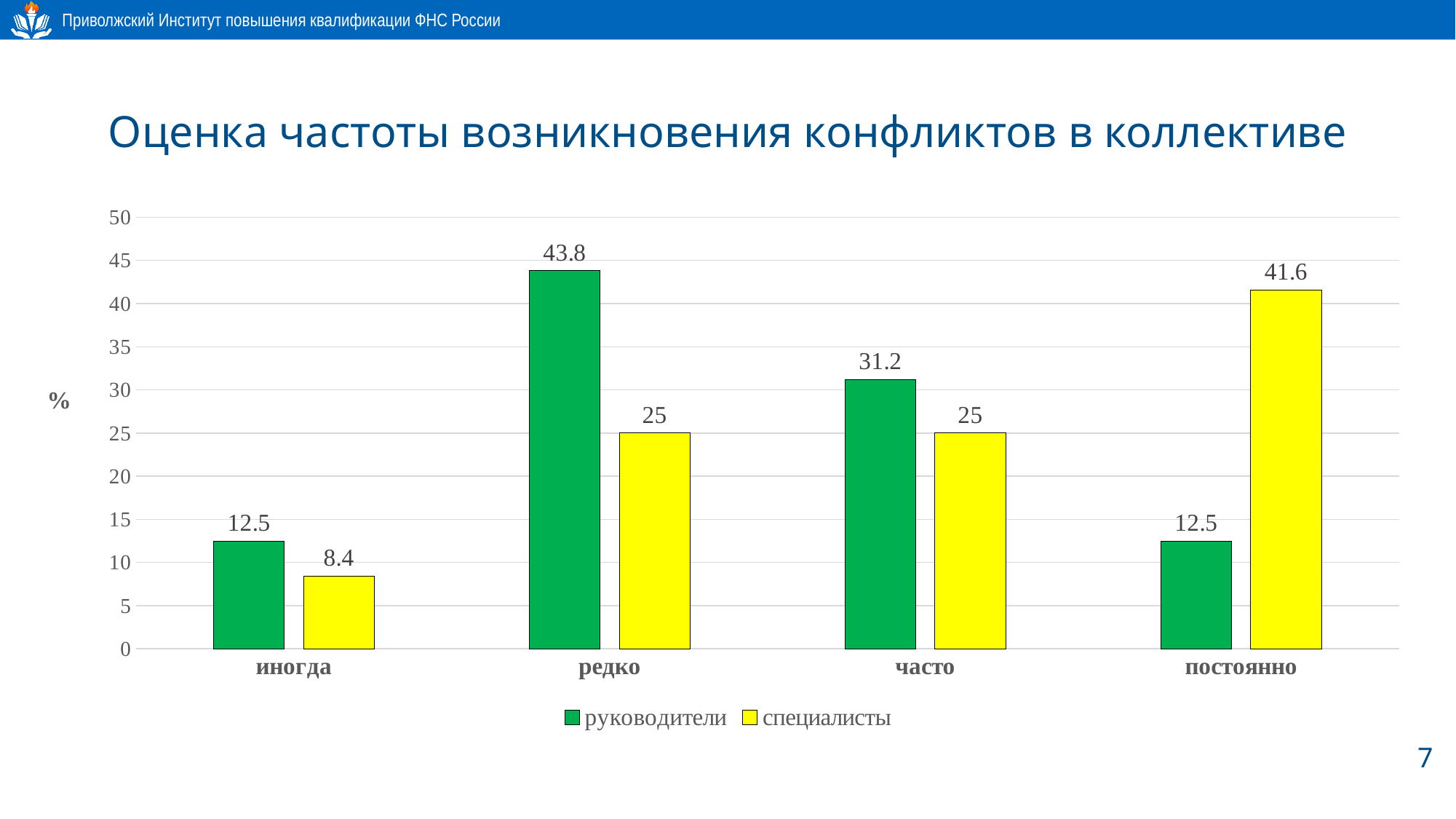
What value is shown for специалисты in the постоянно category? 41.6 How many series does the legend list? 2 What kind of chart is shown on the slide? bar chart Which category has the highest value for руководители? редко What value is shown for руководители in the редко category? 43.8 In the постоянно category, which series has the larger value, руководители or специалисты? специалисты What is the difference between руководители and специалисты in the редко category? 18.8 What value is shown for специалисты in the иногда category? 8.4 How many categories are shown on the x axis? 4 Is the value for руководители in the часто category greater or less than 30? greater Which category has the lowest value for специалисты? иногда What colour are the bars for специалисты? yellow